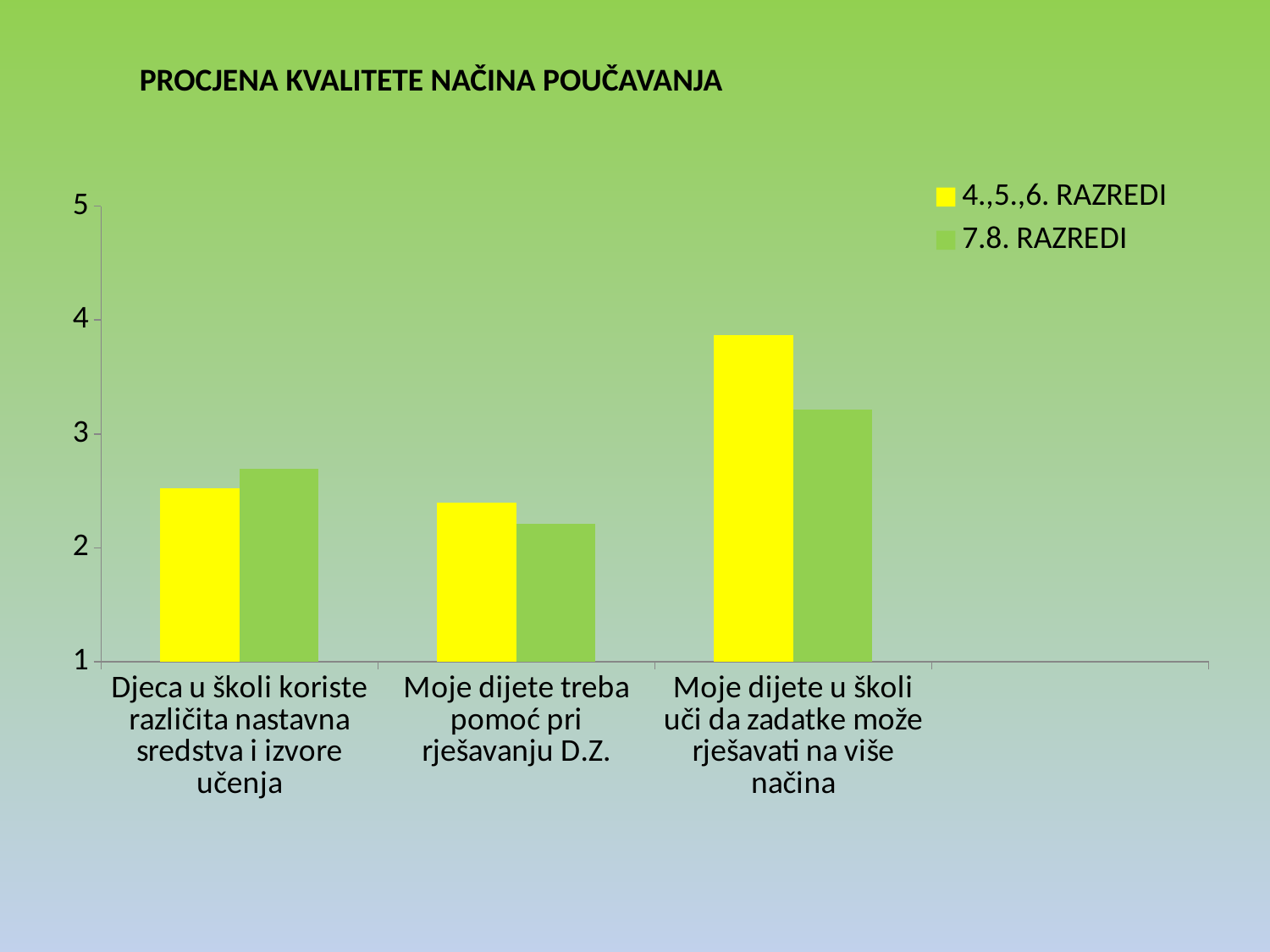
For the category 'Djeca u školi koriste različita nastavna sredstva i izvore učenja', which series has the larger value? 7.8. RAZREDI Is the value for 7.8. RAZREDI in the category 'Djeca u školi koriste različita nastavna sredstva i izvore učenja' greater or less than 3? less What kind of chart is shown on the slide? bar chart For the series 7.8. RAZREDI, which category has the lowest value? Moje dijete treba pomoć pri rješavanju D.Z. For the series 7.8. RAZREDI, which category has the highest value? Moje dijete u školi uči da zadatke može rješavati na više načina For the category 'Moje dijete u školi uči da zadatke može rješavati na više načina', which series has the larger value? 4.,5.,6. RAZREDI Which series is shown in yellow? 4.,5.,6. RAZREDI For the series 4.,5.,6. RAZREDI, which category has the highest value? Moje dijete u školi uči da zadatke može rješavati na više načina Is the value for 4.,5.,6. RAZREDI in the category 'Moje dijete u školi uči da zadatke može rješavati na više načina' greater or less than 3? greater How many categories are shown on the x axis? 3 How many series does the legend list? 2 What is the title of the chart? PROCJENA KVALITETE NAČINA POUČAVANJA